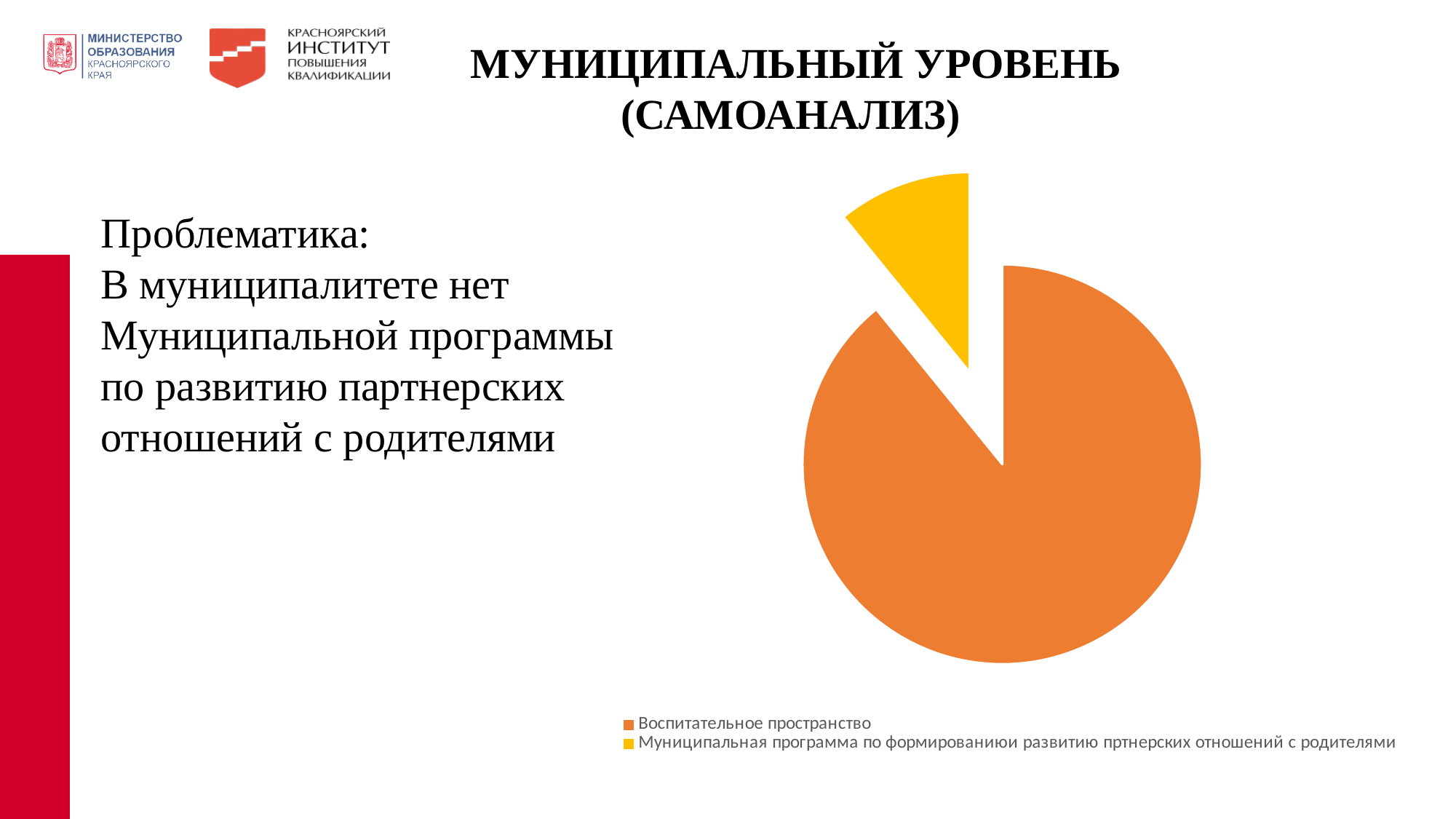
What kind of chart is shown on the slide? Pie chart Which slice is larger: Воспитательное пространство or Муниципальная программа по формированиюи развитию пртнерских отношений с родителями? Воспитательное пространство How many entries does the legend of the pie chart list? 2 What colour is the slice for Воспитательное пространство? Orange Which category has the smallest slice in the pie chart? Муниципальная программа по формированиюи развитию пртнерских отношений с родителями Which legend entry is shown in yellow? Муниципальная программа по формированиюи развитию пртнерских отношений с родителями How many slices does the pie chart have? 2 Which category has the largest slice in the pie chart? Воспитательное пространство